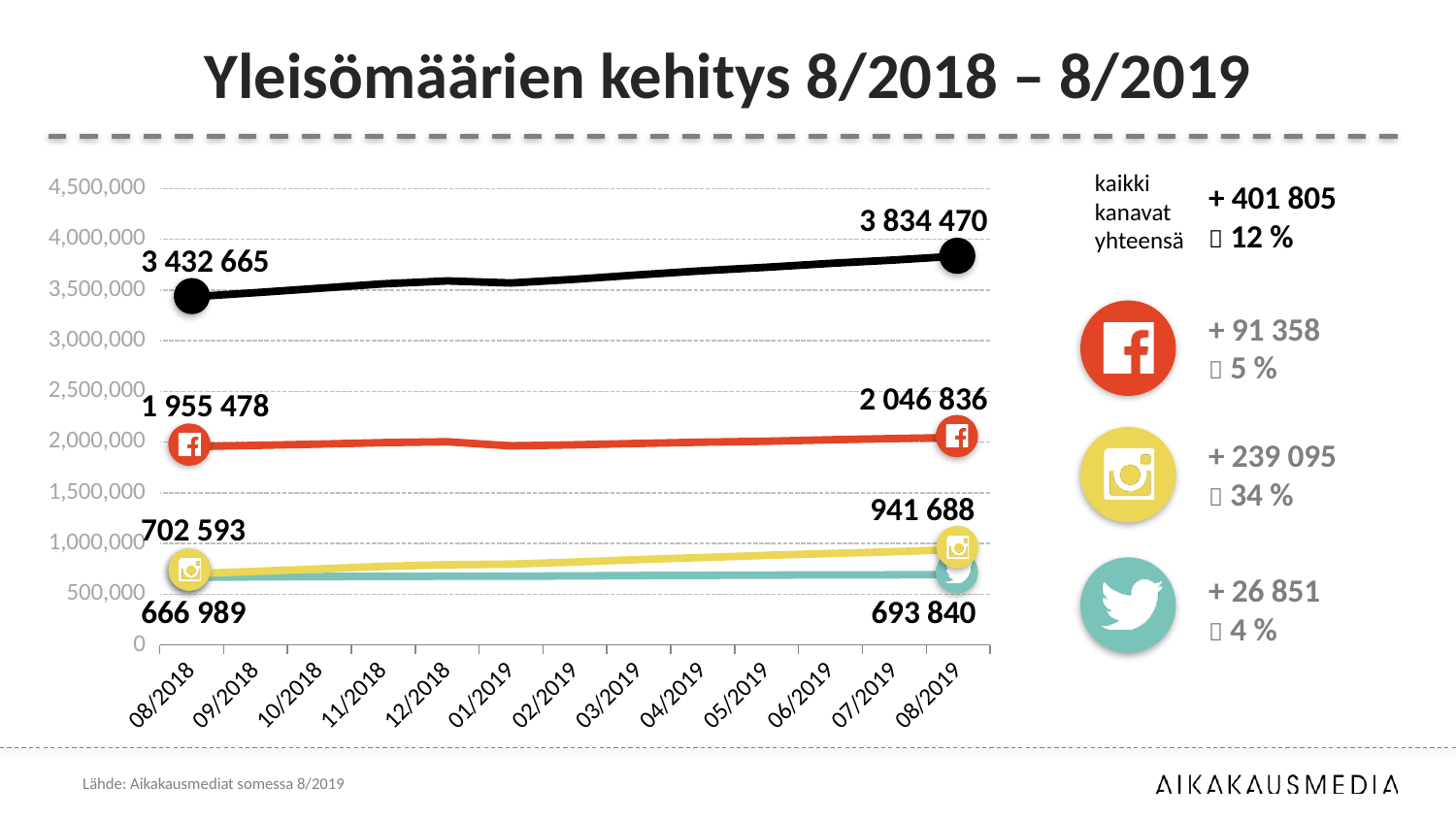
What is the value of the Facebook line at 08/2018? 1 955 478 By how much did the black (total) line increase from 08/2018 to 08/2019? 401 805 Which is larger at 08/2019, the Instagram value or the Twitter value? Instagram What is the value of the Twitter line at 08/2018? 666 989 How many months are shown on the x axis? 13 What is the value of the Instagram line at 08/2019? 941 688 Is the Facebook value at 08/2019 greater or less than 2,000,000? greater By how much did the Instagram line increase from 08/2018 to 08/2019? 239 095 What kind of chart is shown on the slide? line chart Which of the three social media channels has the lowest value at 08/2019? Twitter Does the Instagram line rise or fall from 08/2018 to 08/2019? rise What is the value of the black (total) line at 08/2019? 3 834 470